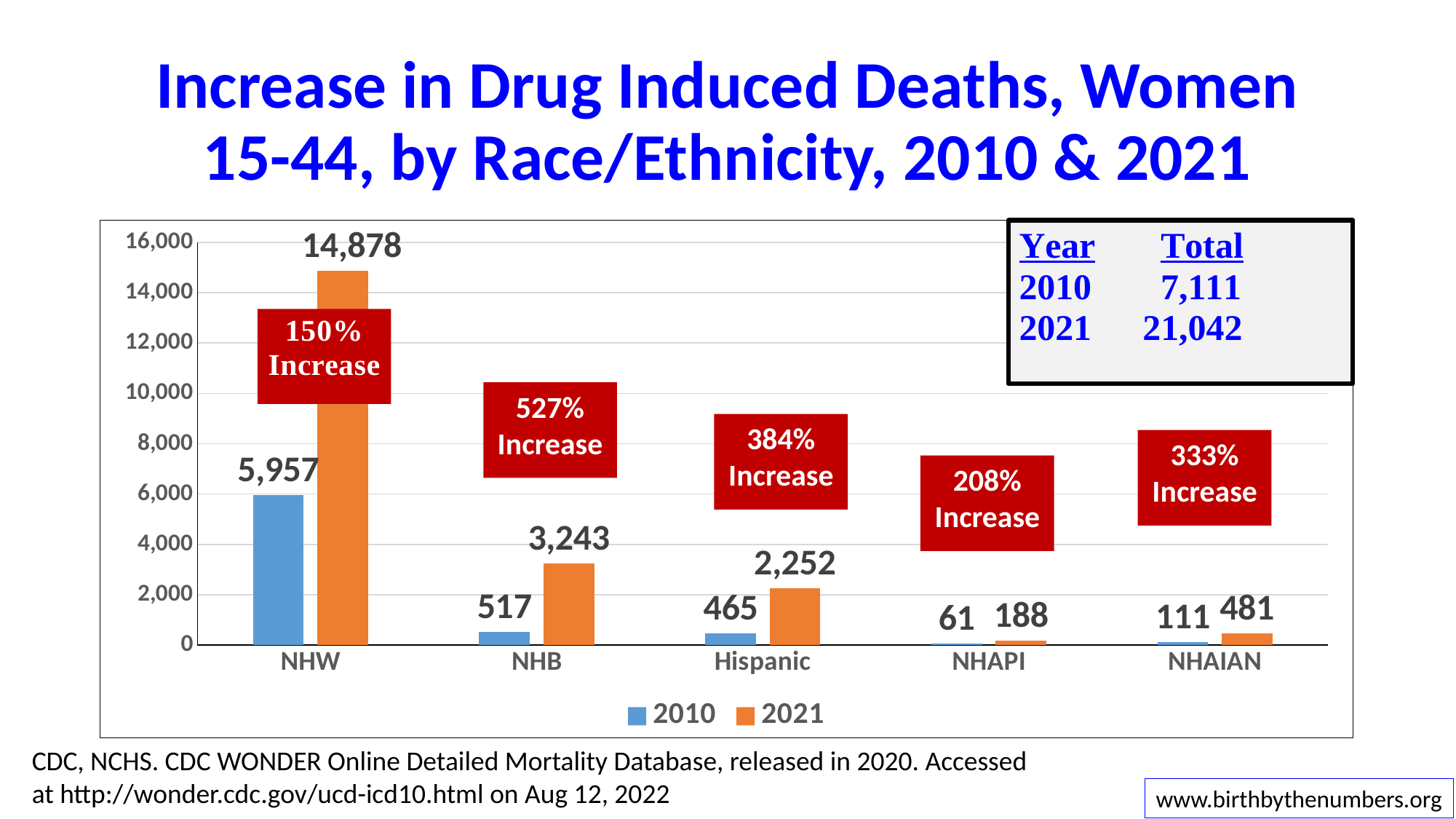
What kind of chart is shown on the slide? Bar chart What is the 2021 value for Hispanic? 2,252 What is the 2010 value for NHAPI? 61 What is the 2021 value for NHW? 14,878 Which is larger, the 2021 value for NHB or the 2021 value for Hispanic? NHB How many race/ethnicity categories are shown on the x axis? 5 How many series does the legend list? 2 What percentage increase is labelled for NHB? 527% Increase Which race/ethnicity category has the highest 2021 value? NHW What is the difference between the 2021 and 2010 values for NHW? 8,921 Which race/ethnicity category has the lowest 2010 value? NHAPI What is the 2010 value for NHB? 517